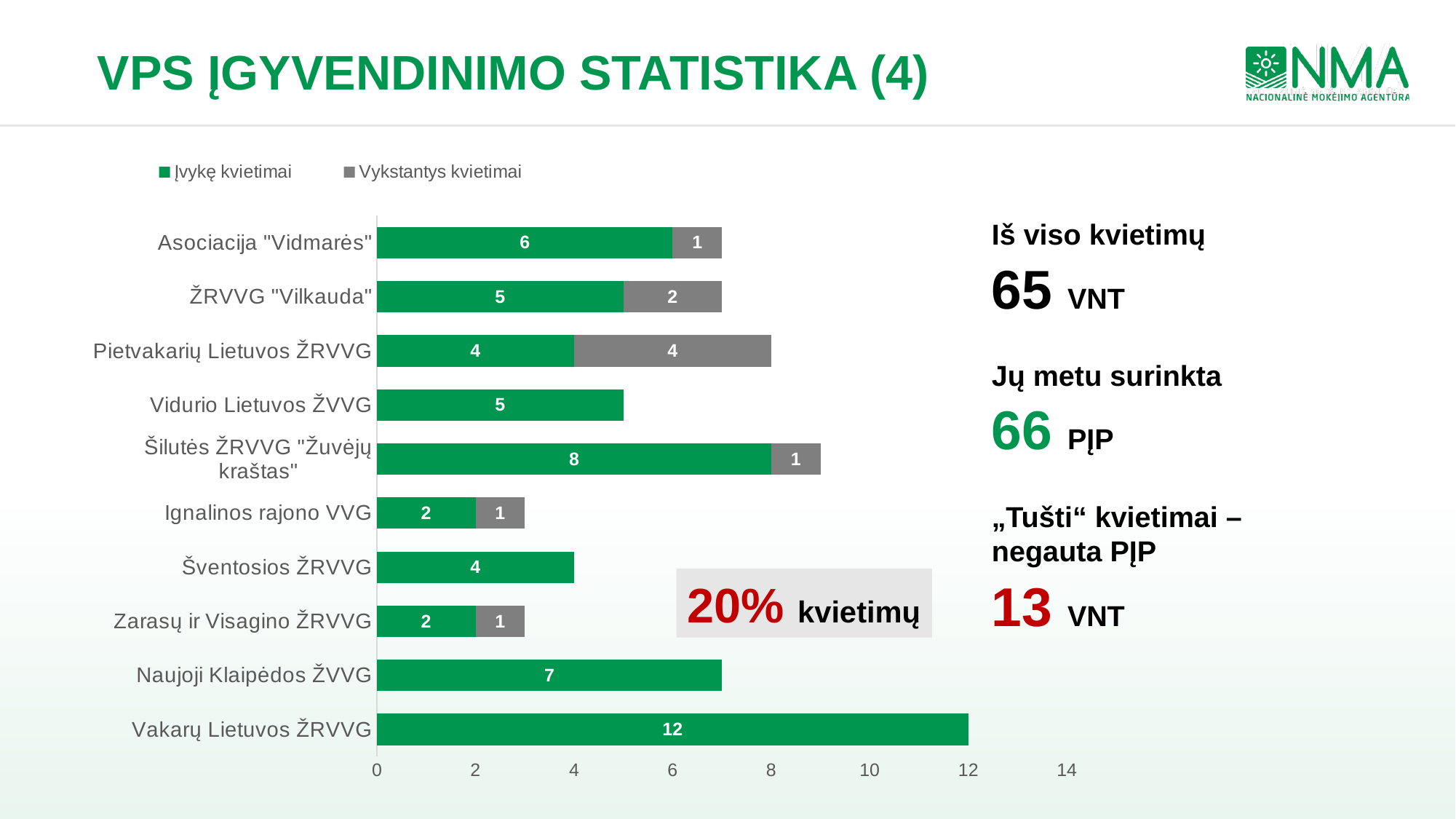
Which organisation has the highest value of Vykstantys kvietimai? Pietvakarių Lietuvos ŽRVVG How many series does the chart legend list? 2 Which is larger: the Įvykę kvietimai value for Asociacija "Vidmarės" or for Ignalinos rajono VVG? Asociacija "Vidmarės" What is the value of Įvykę kvietimai for Vakarų Lietuvos ŽRVVG? 12 What kind of chart is shown on the slide? Stacked bar chart What is the value of Vykstantys kvietimai for ŽRVVG "Vilkauda"? 2 What is the total of the stacked bar for Pietvakarių Lietuvos ŽRVVG? 8 What is the value of Įvykę kvietimai for Šilutės ŽRVVG "Žuvėjų kraštas"? 8 How many categories (organisations) are shown on the chart? 10 Which series is shown in grey in the chart legend? Vykstantys kvietimai What is the difference between the Įvykę kvietimai values for Naujoji Klaipėdos ŽVVG and Šventosios ŽRVVG? 3 Which organisation has the highest value of Įvykę kvietimai? Vakarų Lietuvos ŽRVVG